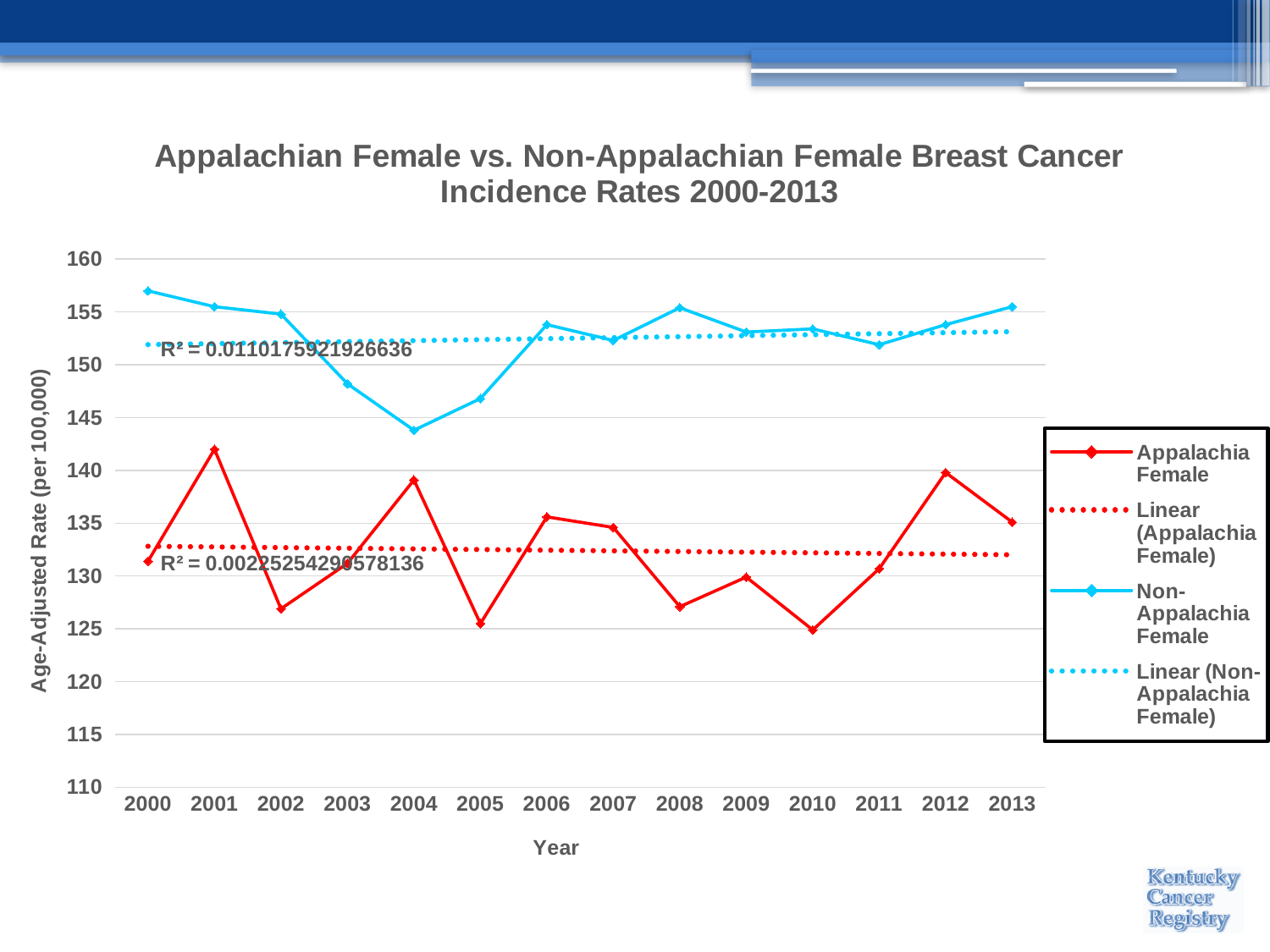
In which year is the Non-Appalachia Female incidence rate lowest? 2004 Is the Non-Appalachia Female value for 2004 greater or less than 145? less Is the Appalachia Female value for 2001 greater or less than 140? greater How many years are plotted along the x axis? 14 What R² value is shown for the Linear (Appalachia Female) trendline? R² = 0.00225254290578136 What kind of chart is shown on the slide? Line chart In 2004, which series has the higher value: Appalachia Female or Non-Appalachia Female? Non-Appalachia Female Does the Non-Appalachia Female line rise or fall from 2000 to 2004? Fall Is the Appalachia Female value for 2010 greater or less than 130? less In which year is the Non-Appalachia Female incidence rate highest? 2000 In which year is the Appalachia Female incidence rate highest? 2001 How many entries does the chart legend list? 4